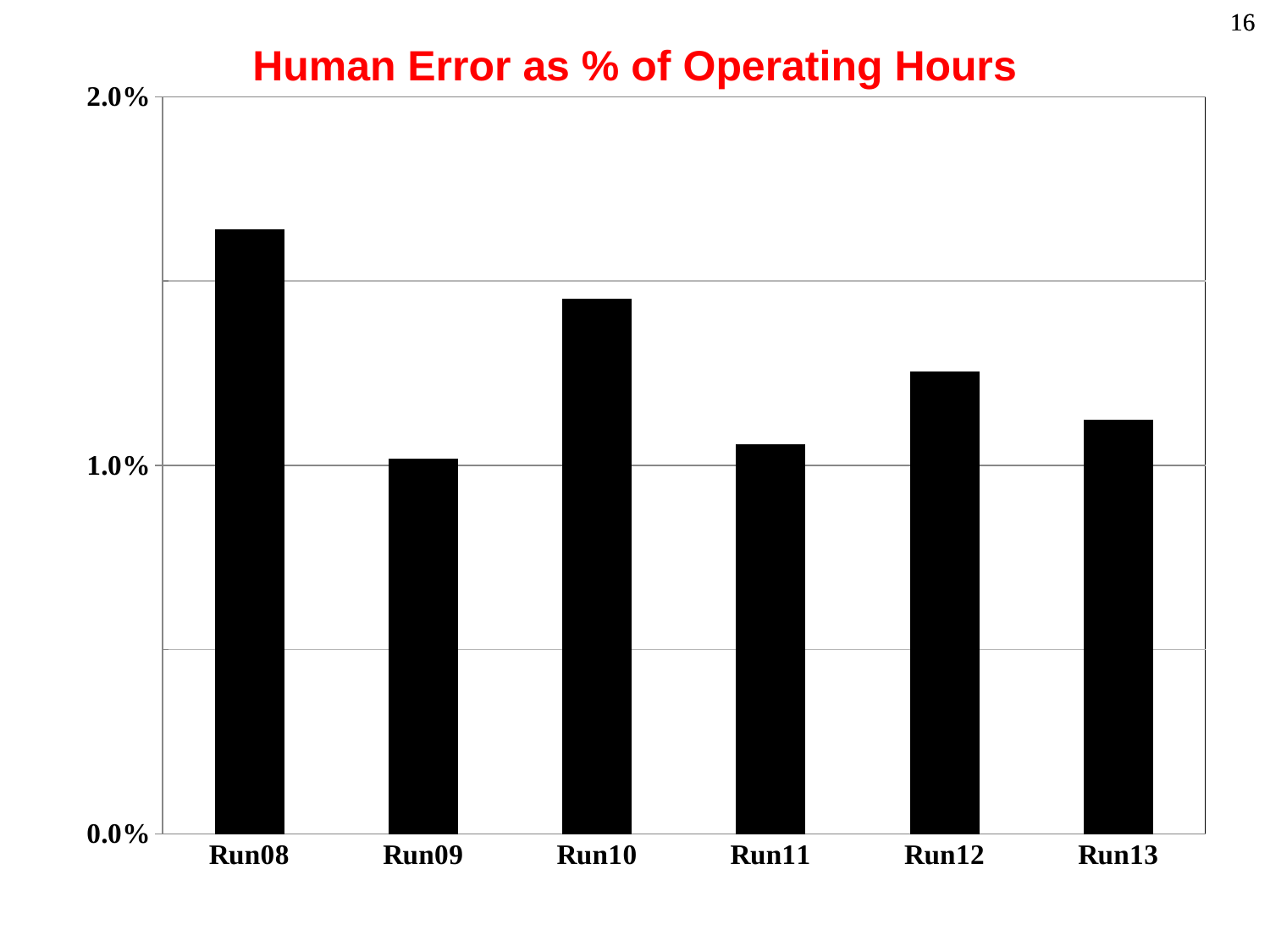
Is the value for Run10 greater or less than 1.0%? greater Which run has the highest human error as % of operating hours? Run08 What is the title of the chart? Human Error as % of Operating Hours Which is larger, the value for Run08 or the value for Run10? Run08 What kind of chart is shown on the slide? bar chart Is the value for Run08 greater or less than 1.0%? greater Is the value for Run08 greater or less than 2.0%? less Which is larger, the value for Run12 or the value for Run09? Run12 Which is larger, the value for Run13 or the value for Run10? Run10 How many runs (categories) are plotted on the x axis? 6 What colour are the bars in the chart? black